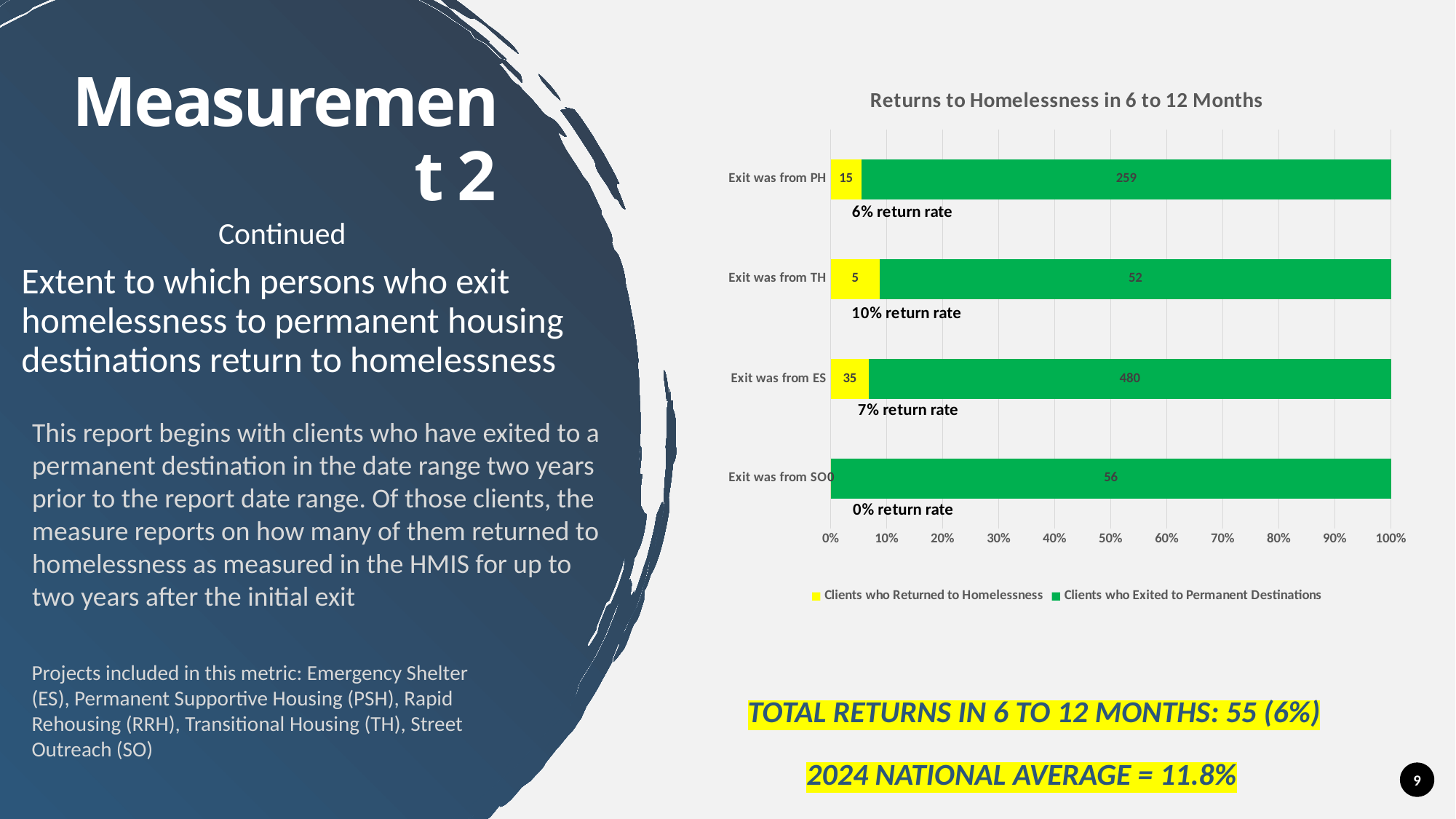
Which is larger: Clients who Returned to Homelessness for 'Exit was from PH' or for 'Exit was from TH'? Exit was from PH Which category has the highest value for Clients who Returned to Homelessness? Exit was from ES What is the value of Clients who Returned to Homelessness for 'Exit was from PH'? 15 How many categories are shown on the chart? 4 What is the value of Clients who Exited to Permanent Destinations for 'Exit was from TH'? 52 What kind of chart is shown on the slide? bar chart What return rate is labelled for 'Exit was from TH'? 10% return rate What is the title of the chart on the slide? Returns to Homelessness in 6 to 12 Months How many series does the chart legend list? 2 What is the difference between Clients who Exited to Permanent Destinations for 'Exit was from ES' and 'Exit was from PH'? 221 Which category has the lowest value for Clients who Exited to Permanent Destinations? Exit was from TH What is the value of Clients who Exited to Permanent Destinations for 'Exit was from ES'? 480